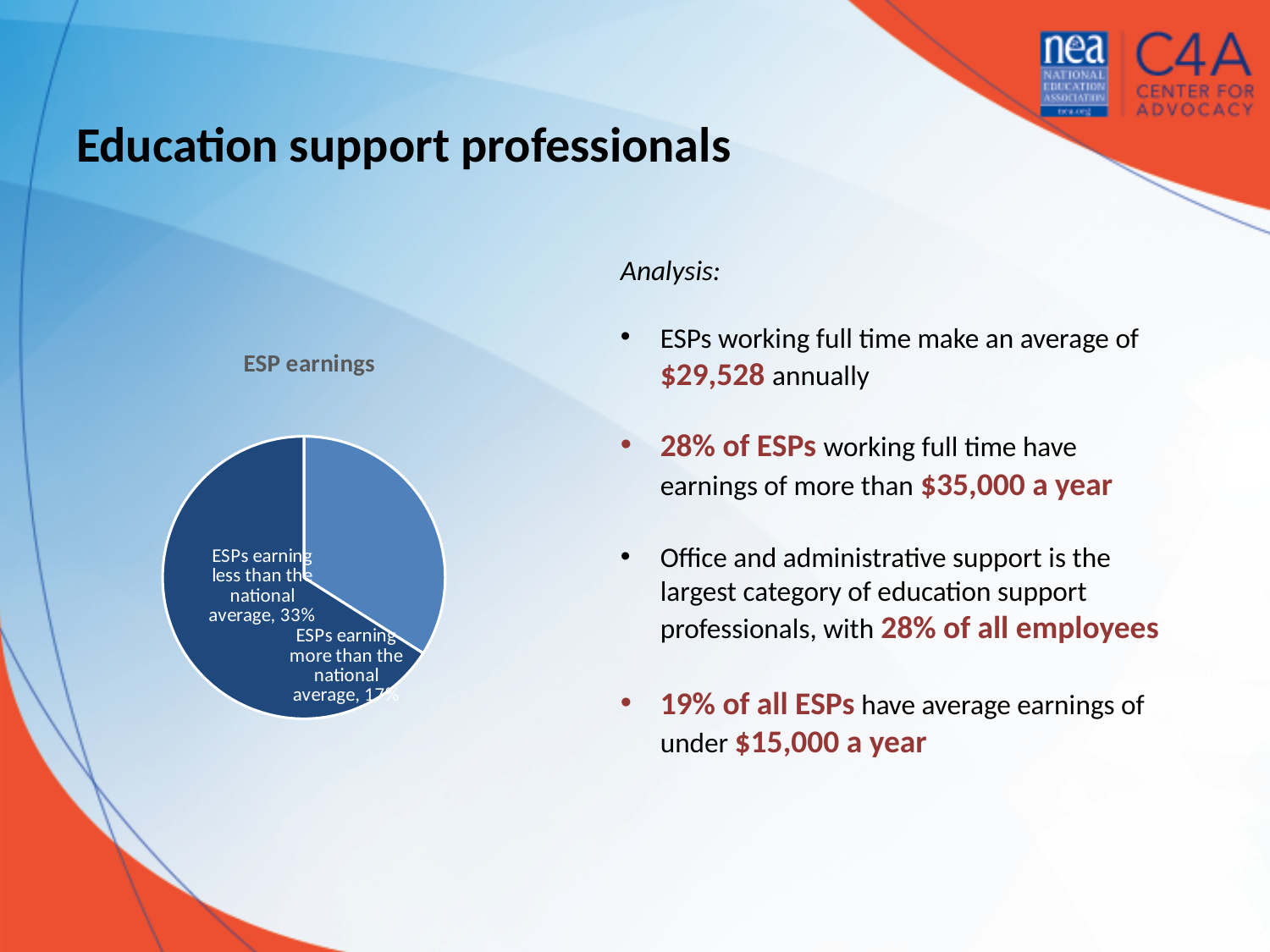
In the ESP earnings chart, which is larger: the slice for ESPs earning less than the national average or the slice for ESPs earning more than the national average? ESPs earning less than the national average Is the value for ESPs earning less than the national average in the ESP earnings chart greater or less than 30%? greater What is the title of the chart on the slide? ESP earnings Which slice of the ESP earnings pie chart is the largest? ESPs earning less than the national average What value is shown for ESPs earning less than the national average in the ESP earnings chart? 33% In the ESP earnings chart, which slice is shown in the darker blue colour? ESPs earning less than the national average Which slice of the ESP earnings pie chart is the smallest? ESPs earning more than the national average What kind of chart is shown on the slide? pie chart How many slices does the ESP earnings pie chart have? 2